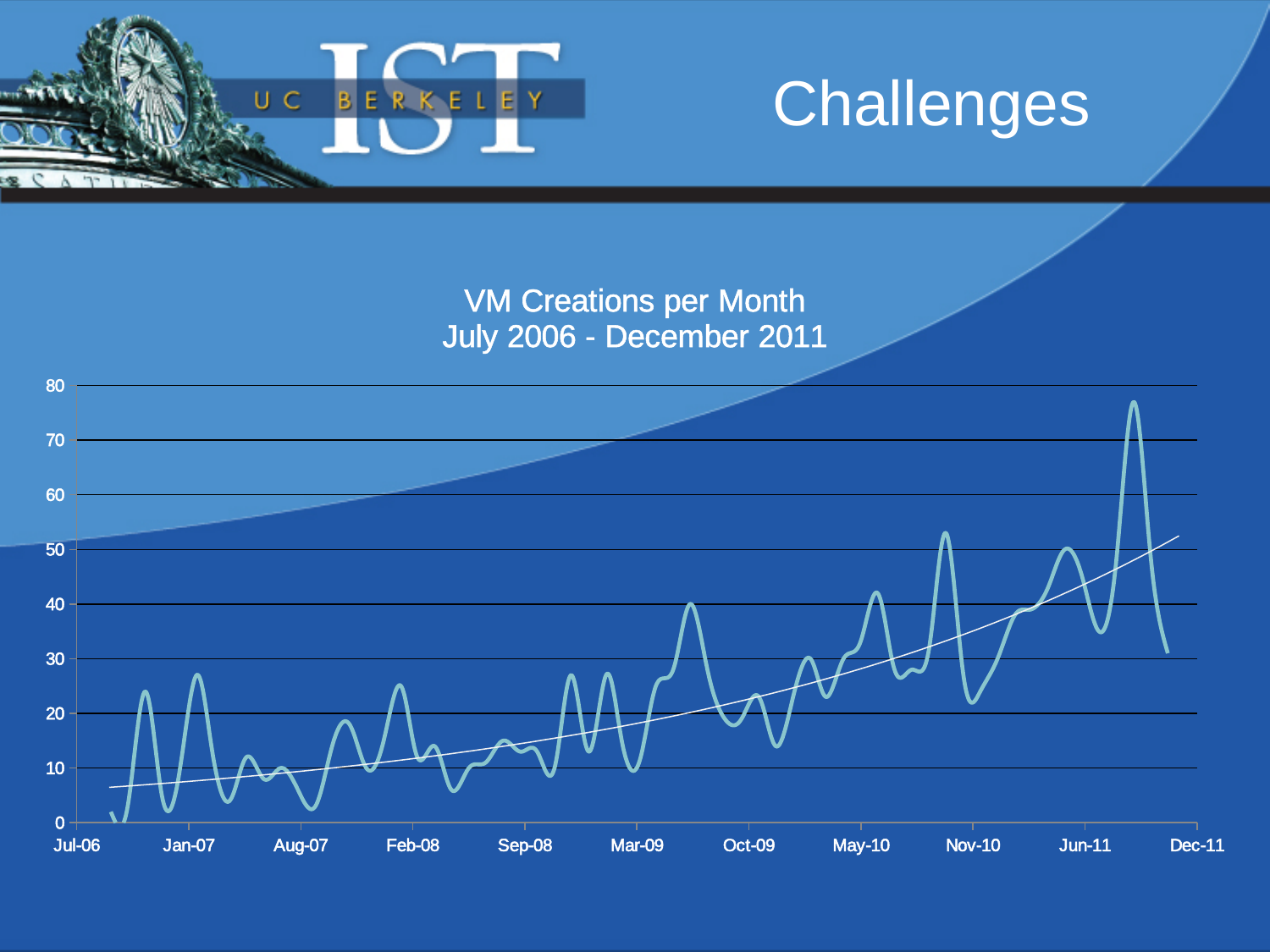
Is the peak near Nov-10 higher or lower than the peak near Jun-11? Higher Is the value at the start of the series in Jul-06 greater or less than 10? less What is the highest value shown on the y axis? 80 Is the highest peak of the VM creations line greater or less than 70? greater Is the value around Jan-07 greater or less than 30? less What is the title of the chart? VM Creations per Month July 2006 - December 2011 Does the thin white trend line rise or fall across the chart? Rise Do VM creations per month generally rise or fall from Jul-06 to Dec-11? Rise How many month labels are shown on the x axis? 11 What kind of chart is shown on the slide? Line chart